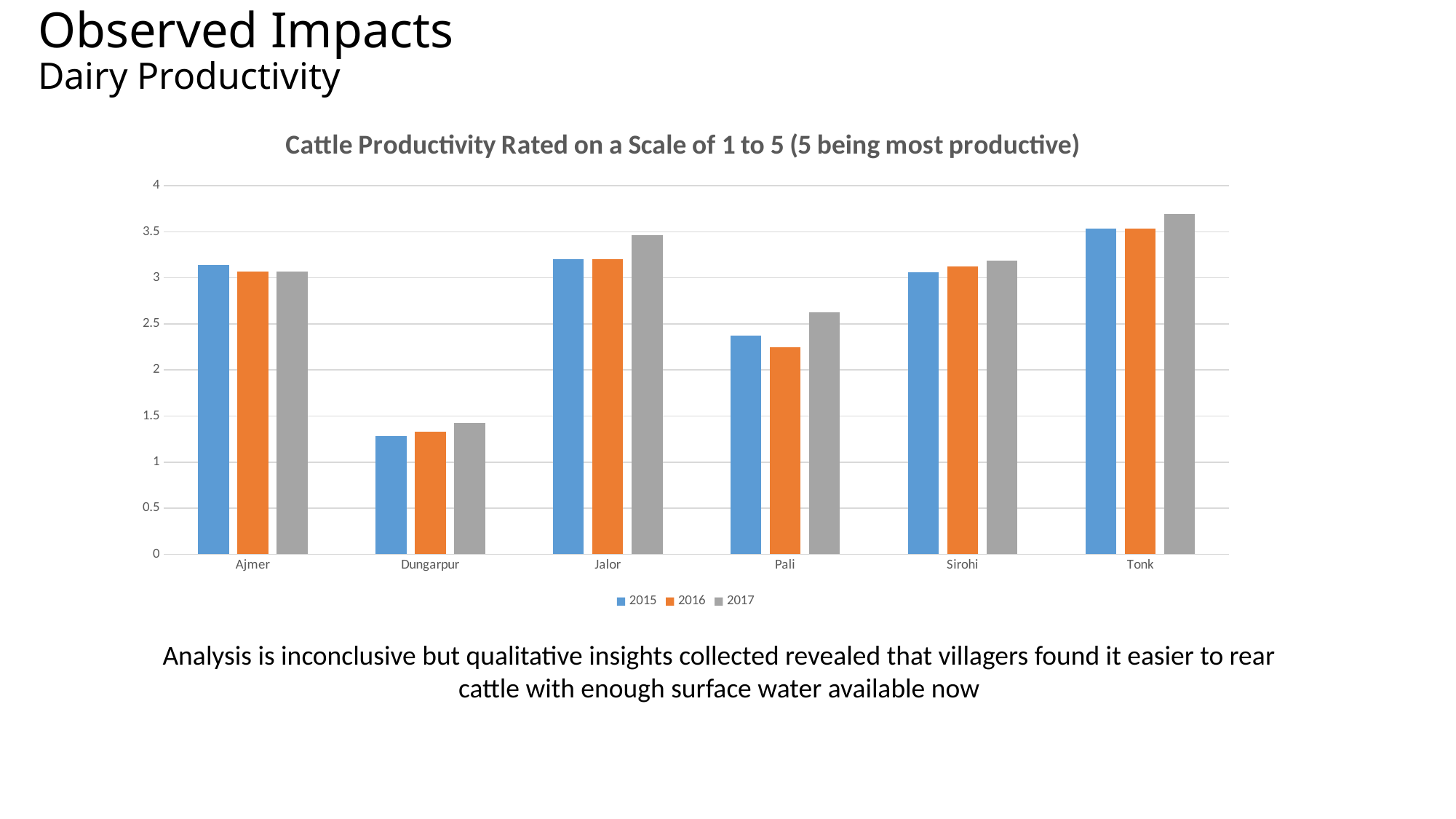
Is the 2015 value for Dungarpur greater or less than 1.5? less Which district has the larger 2017 value: Ajmer or Jalor? Jalor Which district has the highest cattle productivity rating in 2017? Tonk What is the title of the chart? Cattle Productivity Rated on a Scale of 1 to 5 (5 being most productive) Is the 2016 value for Pali greater or less than 2? greater Which is larger for Pali: the 2016 value or the 2017 value? 2017 Is the 2017 value for Tonk greater or less than 3.5? greater What kind of chart is shown on the slide? Bar chart How many districts are shown on the x axis of the chart? 6 How many series does the chart's legend list? 3 Which district has the lowest cattle productivity rating in 2015? Dungarpur Do the values for Dungarpur rise or fall from 2015 to 2017? rise